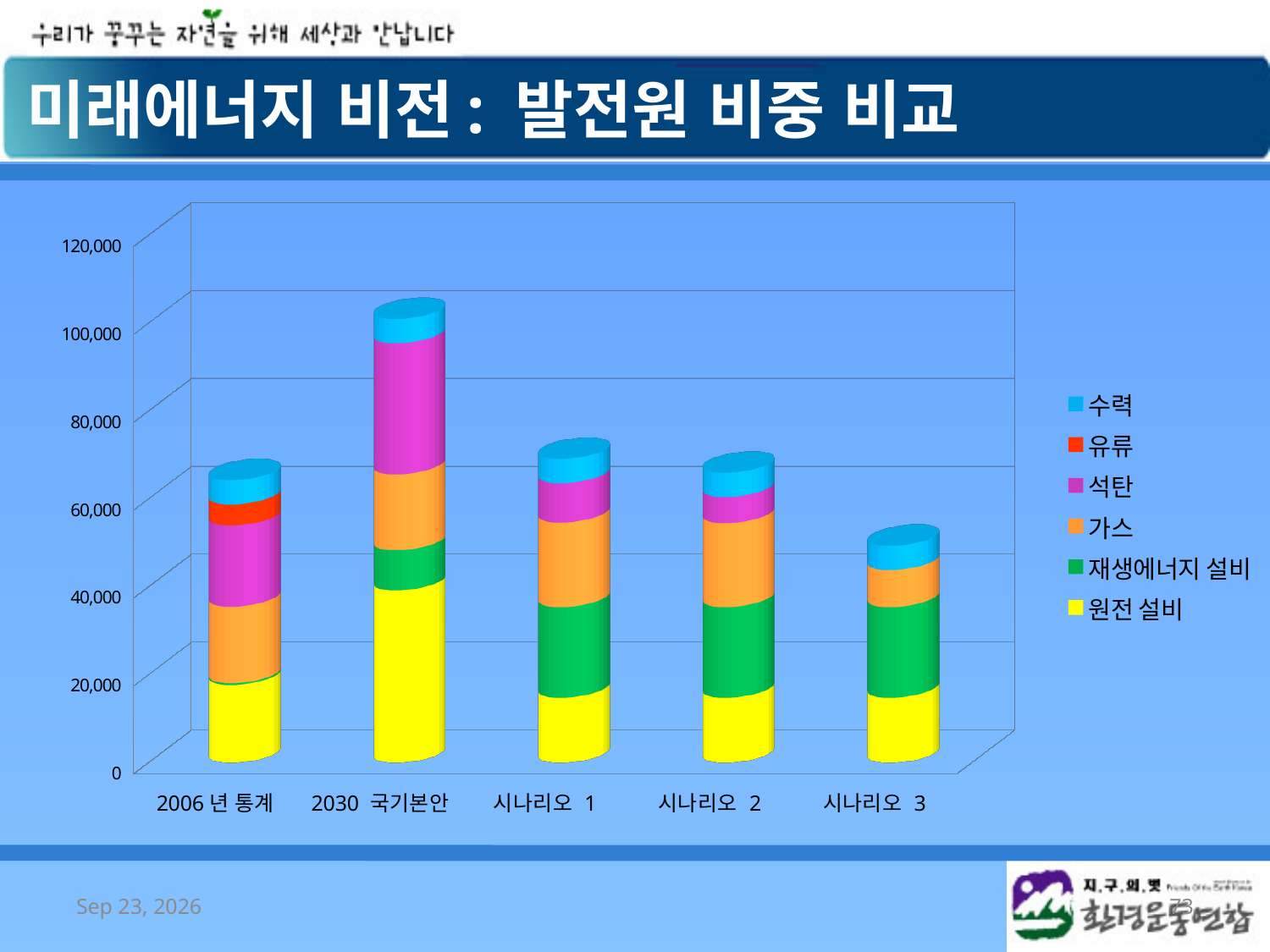
Which has the larger total stacked bar, 2030 국기본안 or 시나리오 1? 2030 국기본안 Is the total stacked value for 시나리오 1 greater or less than 80,000? less Which series appears at the bottom of each stacked bar? 원전 설비 What kind of chart is shown on the slide? stacked bar chart Is the total stacked value for 시나리오 3 greater or less than 60,000? less Which category has the tallest stacked bar? 2030 국기본안 How many categories are shown on the x axis of the chart? 5 Which has the larger total stacked bar, 2006 년 통계 or 시나리오 3? 2006 년 통계 Which category is the only one with a visible 유류 segment? 2006 년 통계 Which category has the shortest stacked bar? 시나리오 3 Is the total stacked value for 2030 국기본안 greater or less than 80,000? greater How many series does the chart's legend list? 6